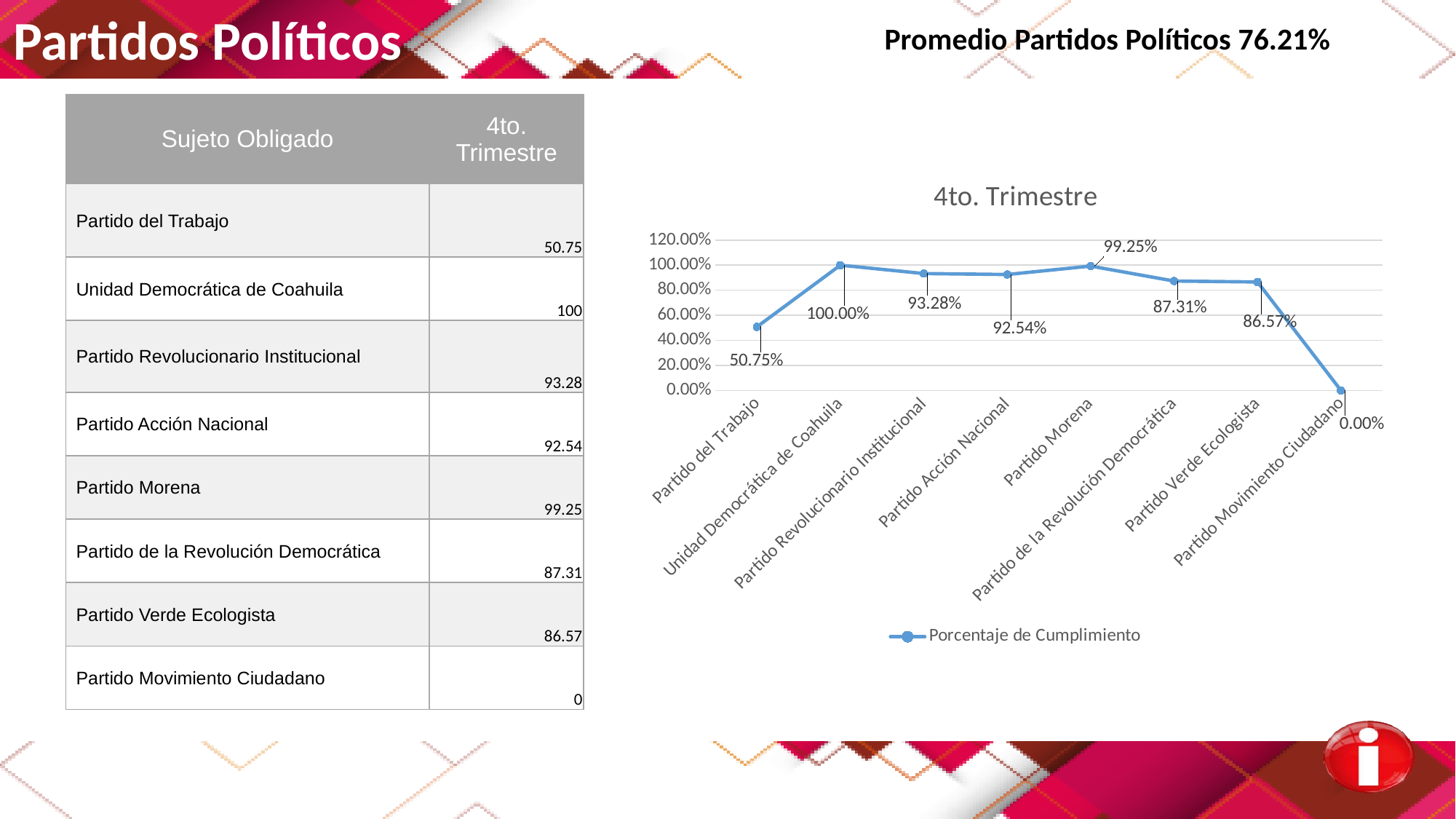
How many categories are plotted on the x axis of the chart? 8 Which category has the lowest value in the chart? Partido Movimiento Ciudadano What is the value for Partido Verde Ecologista in the chart? 86.57% Is the value for Partido del Trabajo greater or less than 60.00%? less Which is larger, the value for Partido de la Revolución Democrática or the value for Partido Verde Ecologista? Partido de la Revolución Democrática What is the difference between the values for Partido Revolucionario Institucional and Partido Acción Nacional? 0.74% What kind of chart is shown on the slide? line chart What is the value for Partido Morena in the chart? 99.25% What is the title of the chart? 4to. Trimestre How many series does the chart legend list? 1 What is the value for Partido del Trabajo in the chart? 50.75% Which category has the highest value in the chart? Unidad Democrática de Coahuila